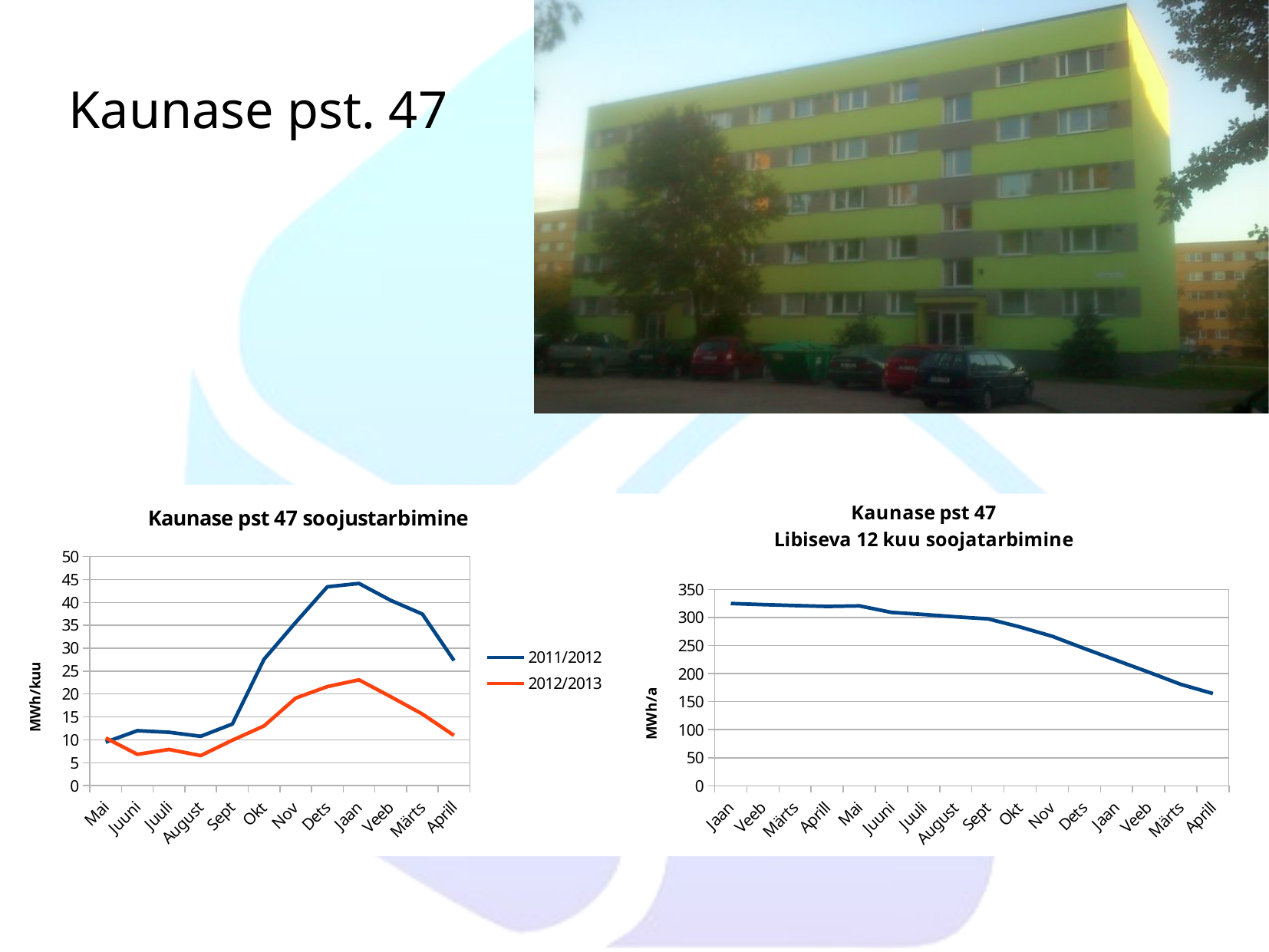
What kind of chart is the 'Kaunase pst 47 soojustarbimine' chart on the left? line chart What kind of chart is the right chart 'Kaunase pst 47 Libiseva 12 kuu soojatarbimine'? line chart In the left chart 'Kaunase pst 47 soojustarbimine', in which month does the 2011/2012 series reach its highest value? Jaan How many series does the legend of the left chart 'Kaunase pst 47 soojustarbimine' list? 2 In the left chart 'Kaunase pst 47 soojustarbimine', which series is shown in orange? 2012/2013 In the right chart 'Kaunase pst 47 Libiseva 12 kuu soojatarbimine', do the values rise or fall from Jaan to Aprill along the x axis? fall How many months are shown on the x axis of the left chart 'Kaunase pst 47 soojustarbimine'? 12 In the right chart 'Kaunase pst 47 Libiseva 12 kuu soojatarbimine', is the value for the last Aprill greater or less than 200? less In the left chart 'Kaunase pst 47 soojustarbimine', is the 2011/2012 value for Jaan greater or less than 40? greater What is the y-axis label of the right chart 'Kaunase pst 47 Libiseva 12 kuu soojatarbimine'? MWh/a In the left chart 'Kaunase pst 47 soojustarbimine', which series has the larger value in Dets, 2011/2012 or 2012/2013? 2011/2012 In the left chart 'Kaunase pst 47 soojustarbimine', is the 2012/2013 value for Jaan greater or less than 20? greater